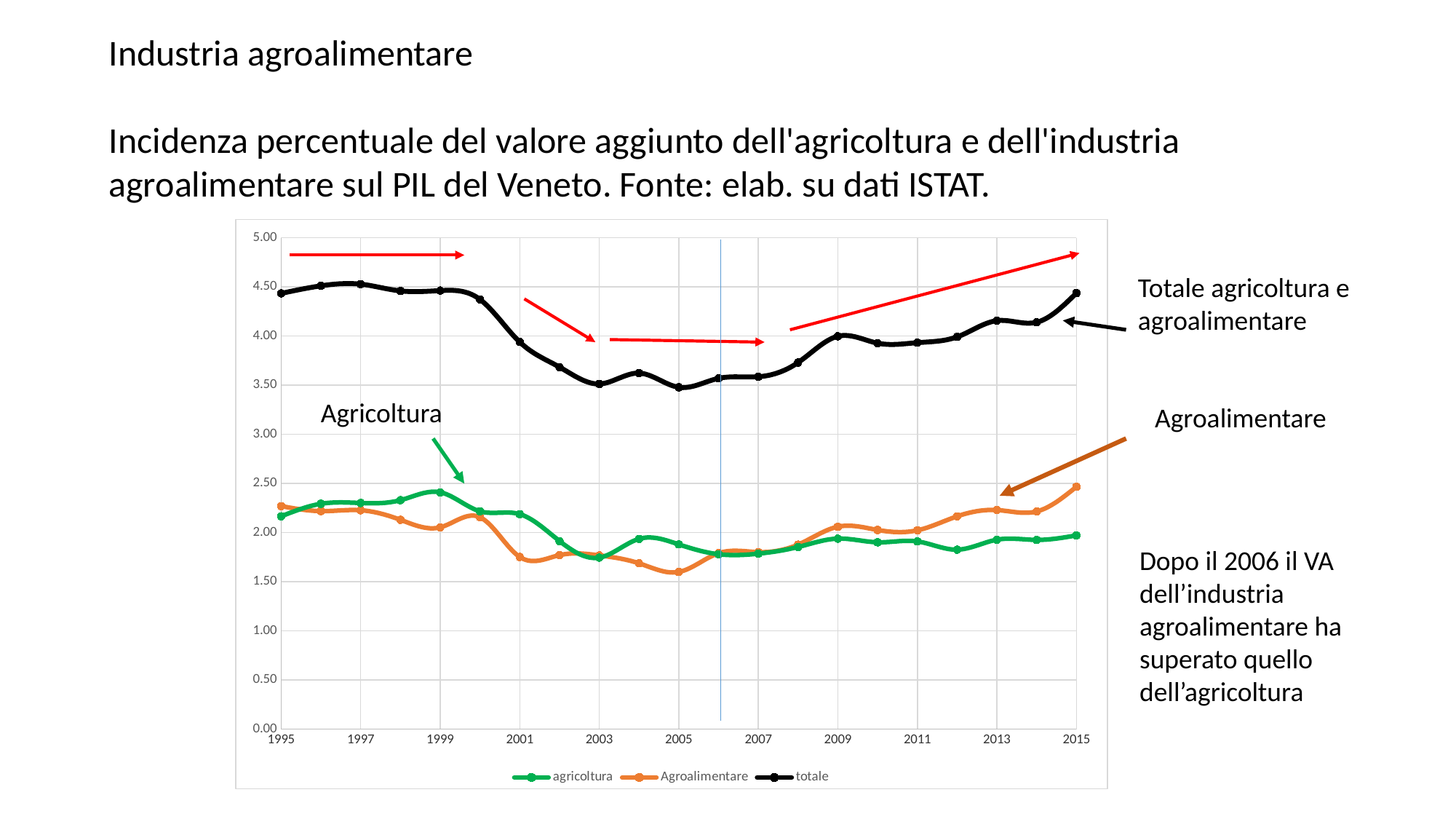
In 1999, which series has the larger value: agricoltura or Agroalimentare? agricoltura Which series are listed in the chart legend? agricoltura, Agroalimentare, totale In which year does the Agroalimentare series reach its highest value? 2015 In which year does the Agroalimentare series reach its lowest value? 2005 Is the value of the Agroalimentare series in 2005 greater or less than 2.00? less How many series does the chart legend list? 3 In which year does the agricoltura series reach its highest value? 1999 What kind of chart is shown on the slide? Line chart Is the value of the totale series in 1995 greater or less than 4.00? greater Does the totale series rise or fall between 2009 and 2015? rise How many years (data points per series) are plotted on the x axis, from 1995 to 2015? 21 In 2015, which series has the larger value: agricoltura or Agroalimentare? Agroalimentare